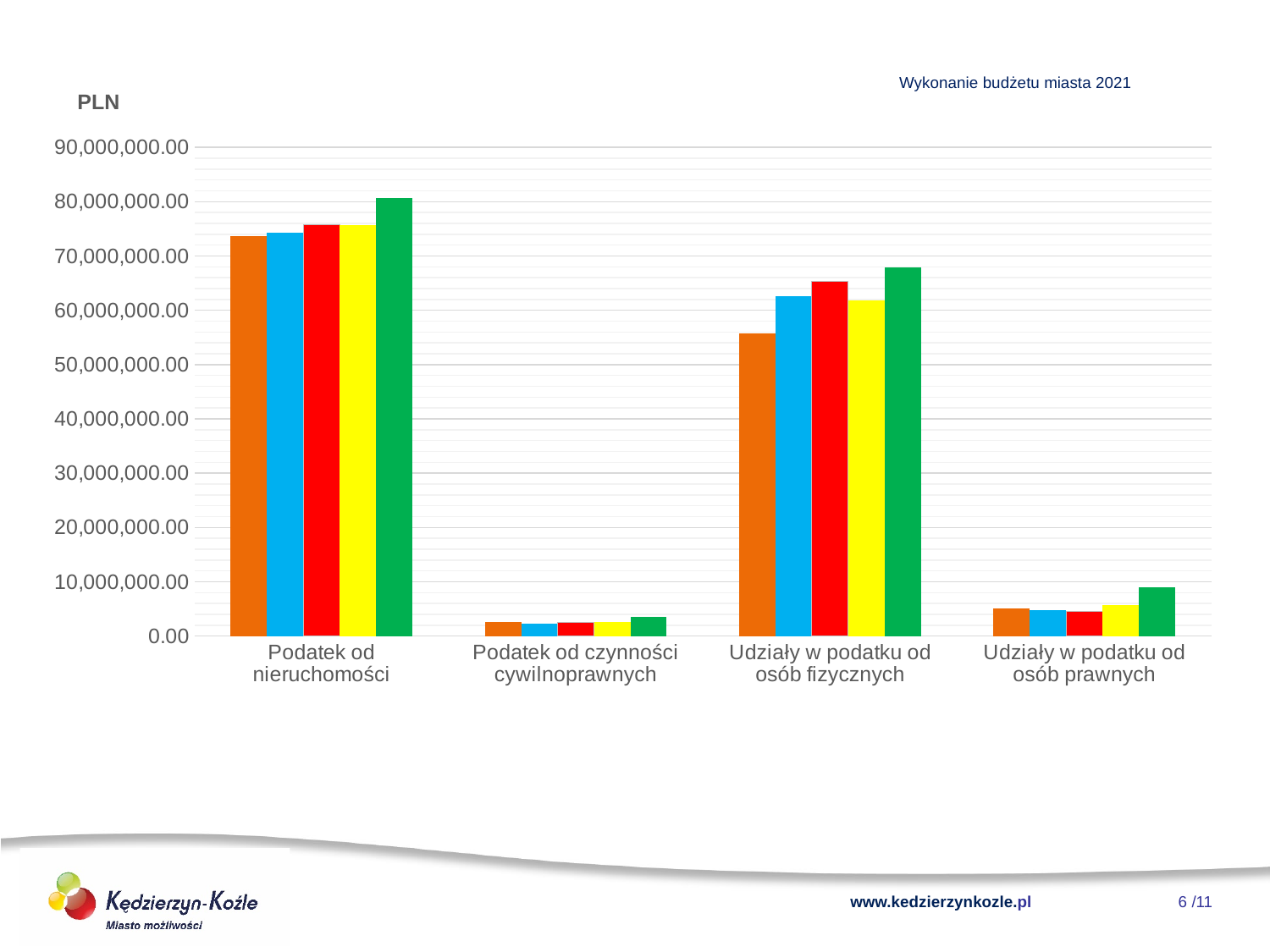
Is the value of the orange bar for Udziały w podatku od osób fizycznych greater or less than 60,000,000.00? less How many categories are shown on the x axis of the chart? 4 What is the title text shown at the top right of the slide above the chart? Wykonanie budżetu miasta 2021 Which category has larger values: Udziały w podatku od osób prawnych or Podatek od czynności cywilnoprawnych? Udziały w podatku od osób prawnych What unit is shown at the top of the vertical axis of the chart? PLN What kind of chart is shown on the slide? bar chart Which category has larger values: Podatek od nieruchomości or Udziały w podatku od osób fizycznych? Podatek od nieruchomości Which category has the highest values in the chart? Podatek od nieruchomości Is the value of the green bar for Podatek od nieruchomości greater or less than 70,000,000.00? greater Which category has the lowest values in the chart? Podatek od czynności cywilnoprawnych How many bars are plotted for each category in the chart? 5 Are the bars for Podatek od czynności cywilnoprawnych greater or less than 10,000,000.00? less